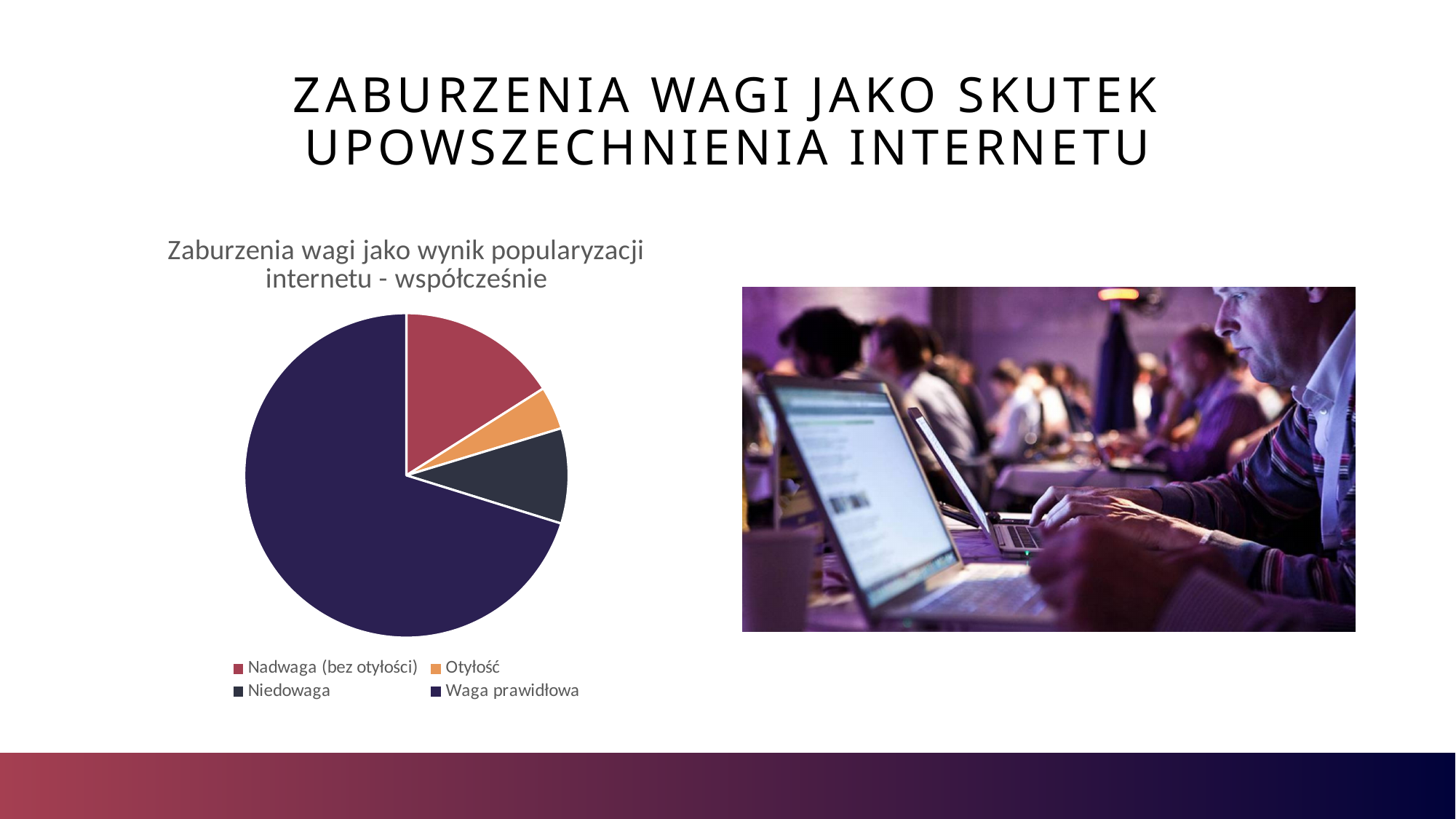
Which category is shown in orange in the pie chart? Otyłość Which category has the largest slice of the pie chart? Waga prawidłowa Which slice is larger: Nadwaga (bez otyłości) or Otyłość? Nadwaga (bez otyłości) Which category has the smallest slice of the pie chart? Otyłość Which slice is larger: Niedowaga or Waga prawidłowa? Waga prawidłowa How many categories does the pie chart show? 4 What is the title of the chart on the slide? Zaburzenia wagi jako wynik popularyzacji internetu - współcześnie Does the Waga prawidłowa slice make up more or less than half of the pie chart? more Which slice is larger: Otyłość or Niedowaga? Niedowaga What kind of chart is shown on the slide? Pie chart